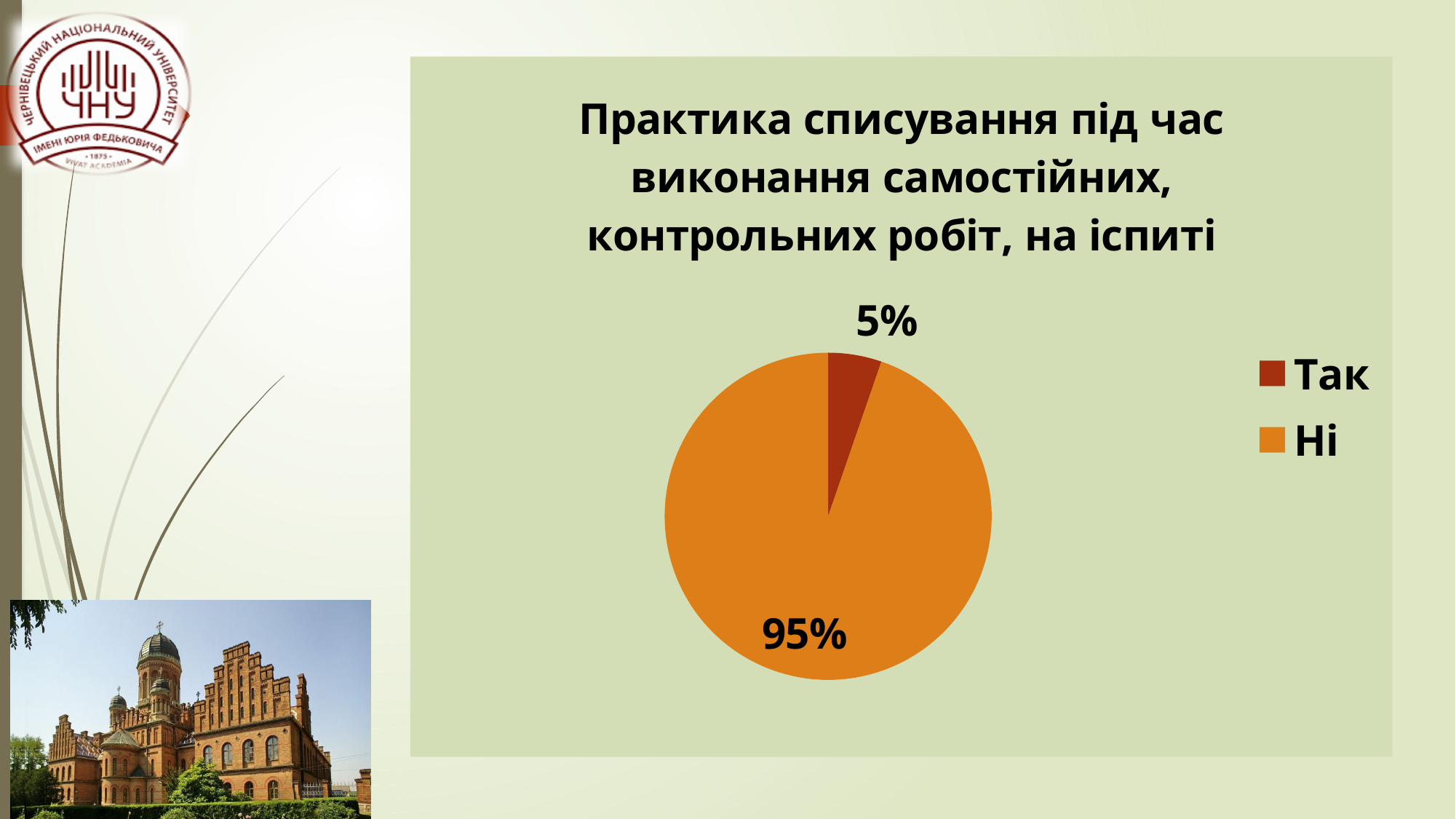
Which is larger, the "Так" slice or the "Ні" slice? Ні What share of the pie does the "Так" slice represent? 5% What colour is the "Ні" slice in the pie chart? Orange What is the difference in percentage points between the "Ні" and "Так" slices? 90% What share of the pie does the "Ні" slice represent? 95% What is the title of the chart? Практика списування під час виконання самостійних, контрольних робіт, на іспиті How many categories does the pie chart show? 2 What is the total of the two slices shown in the pie chart? 100% Which category has the largest slice of the pie? Ні What kind of chart is shown on the slide? Pie chart Which category has the smallest slice of the pie? Так